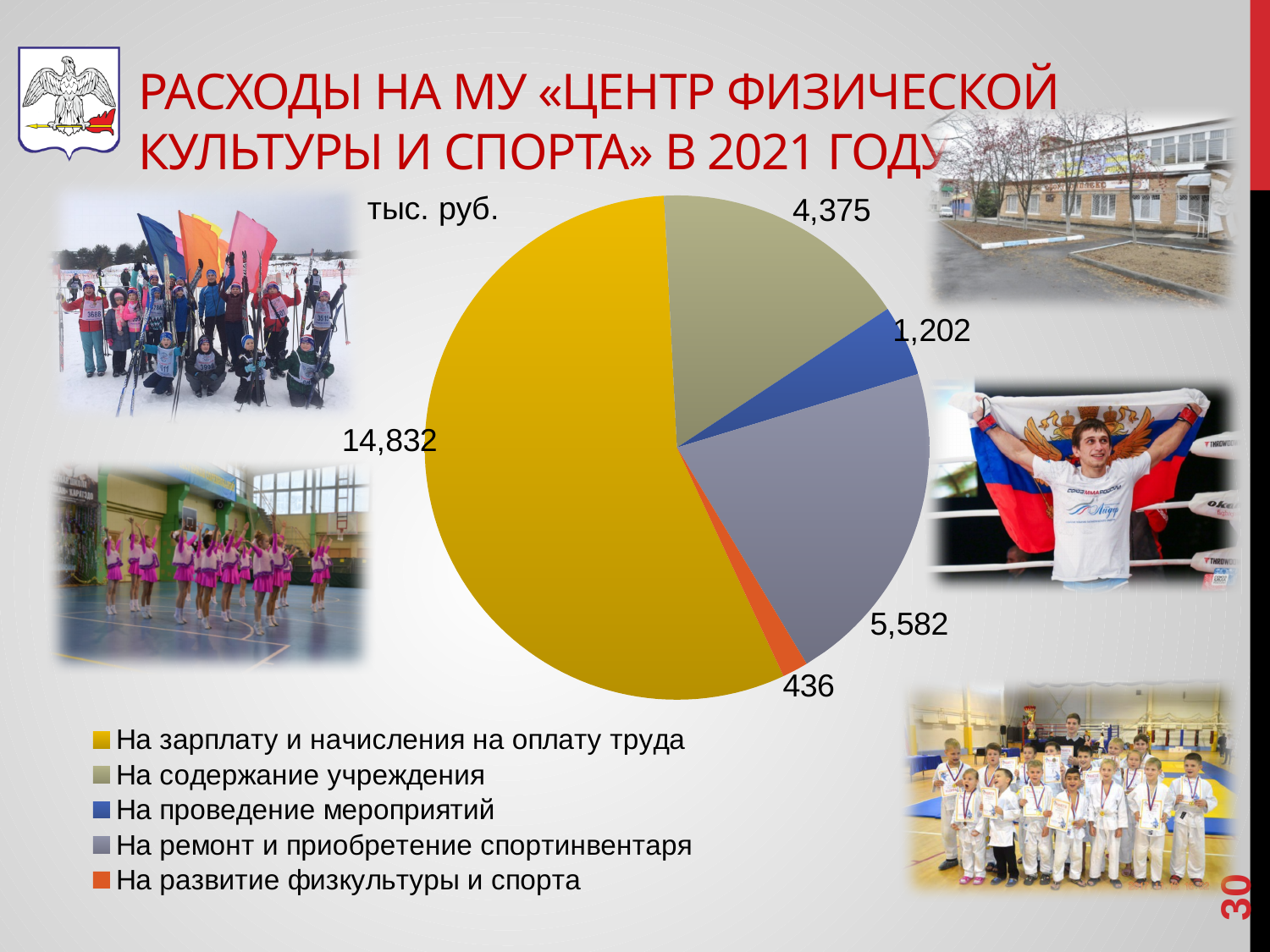
How many slices does the pie chart have? 5 What is the value for «На проведение мероприятий»? 1,202 What is the value for «На развитие физкультуры и спорта»? 436 Which is larger: the value for «На ремонт и приобретение спортинвентаря» or for «На содержание учреждения»? На ремонт и приобретение спортинвентаря What is the value for «На содержание учреждения»? 4,375 Which category has the smallest share of expenses? На развитие физкультуры и спорта How many entries does the legend list? 5 What type of chart is shown on the slide? pie chart What is the value for «На зарплату и начисления на оплату труда»? 14,832 What is the value for «На ремонт и приобретение спортинвентаря»? 5,582 What is the difference between the values for «На ремонт и приобретение спортинвентаря» and «На содержание учреждения»? 1,207 Which category has the largest share of expenses? На зарплату и начисления на оплату труда